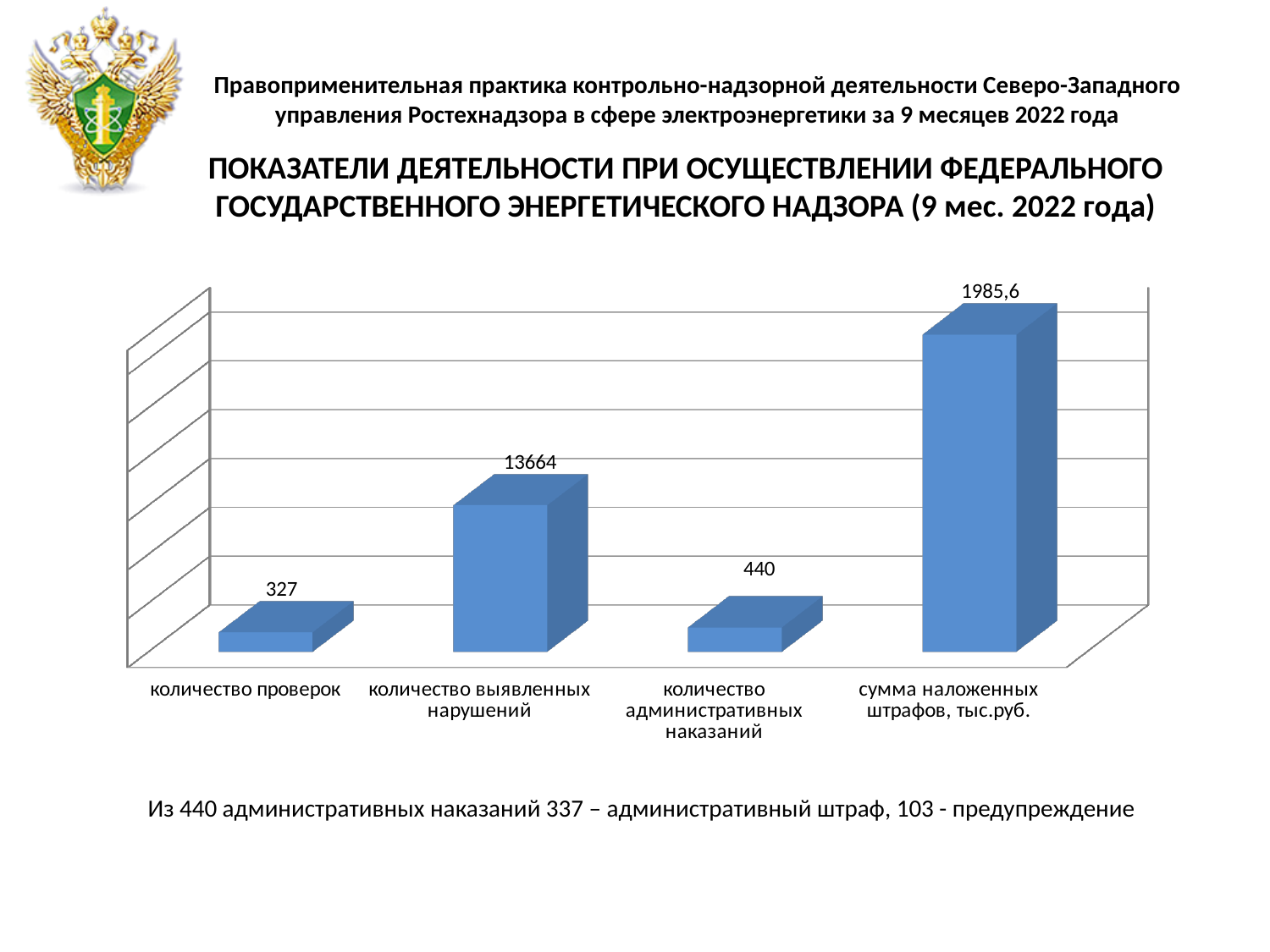
According to the text below the chart, how many of the 440 administrative penalties were warnings (предупреждение)? 103 What is the value for количество проверок? 327 What is the difference between the values for количество административных наказаний and количество проверок? 113 What colour are the bars in the chart? blue Which is larger by its printed value: количество выявленных нарушений or количество административных наказаний? количество выявленных нарушений What kind of chart is shown on the slide? bar chart What is the difference between the values for количество выявленных нарушений and количество административных наказаний? 13224 What is the value for сумма наложенных штрафов, тыс.руб.? 1985,6 How many categories are shown on the x axis of the chart? 4 What is the value for количество административных наказаний? 440 What is the value for количество выявленных нарушений? 13664 Which is larger by its printed value: количество проверок or количество административных наказаний? количество административных наказаний